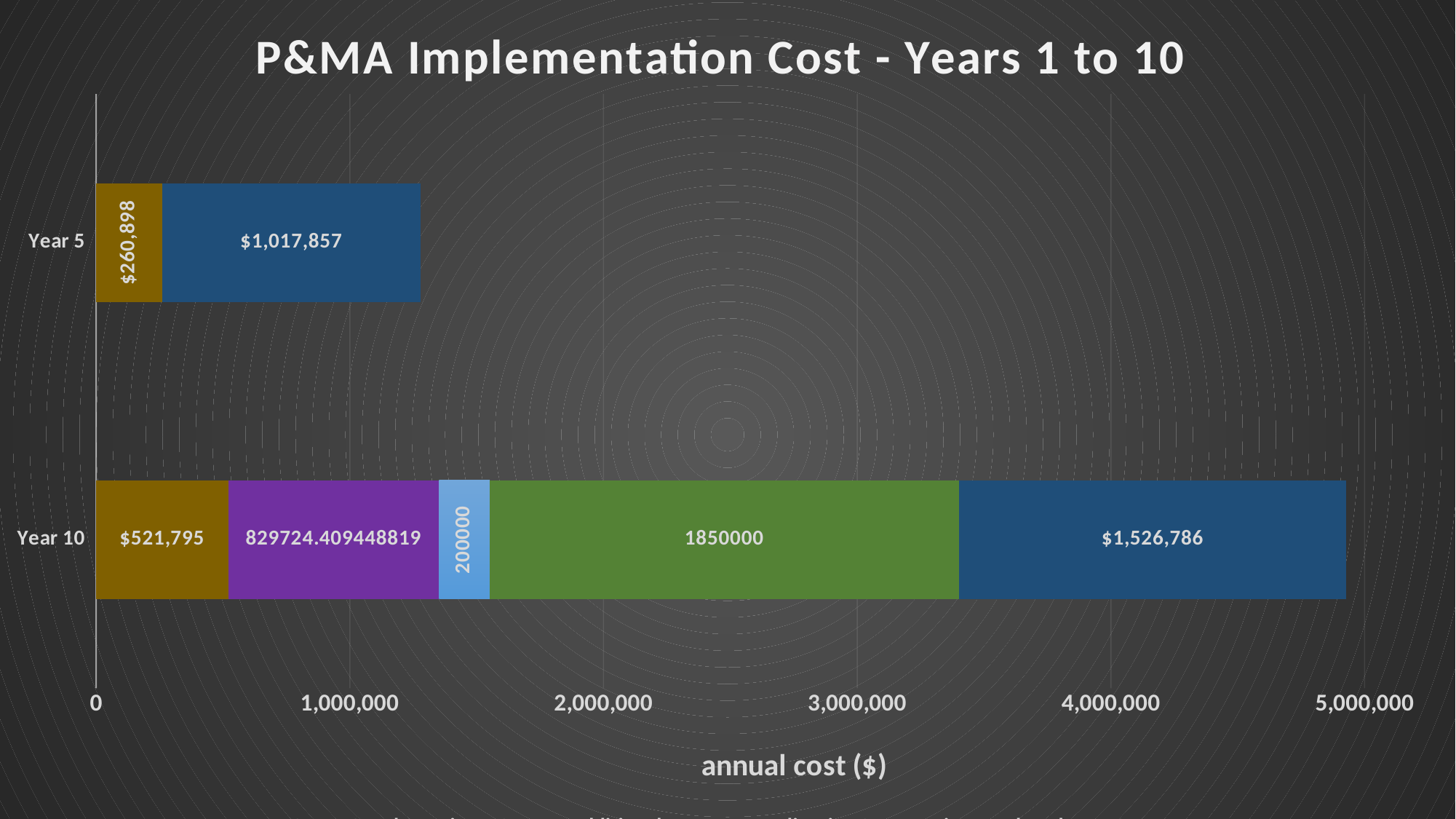
What is the value of the green segment for Year 10? 1850000 How much larger is the gold segment for Year 10 than the gold segment for Year 5? $260,897 What is the title of the chart? P&MA Implementation Cost - Years 1 to 10 What is the label on the horizontal axis? annual cost ($) What is the total of the stacked bar for Year 5? $1,278,755 Is the total length of the Year 10 bar greater or less than 4,000,000? greater Which segment of the Year 10 bar has the largest value? The green segment (1850000) What kind of chart is shown on the slide? Stacked bar chart How many year categories are plotted on the chart? 2 What is the value of the gold (leftmost) segment for Year 5? $260,898 What is the value of the dark blue segment for Year 5? $1,017,857 What is the value of the light blue segment for Year 10? 200000